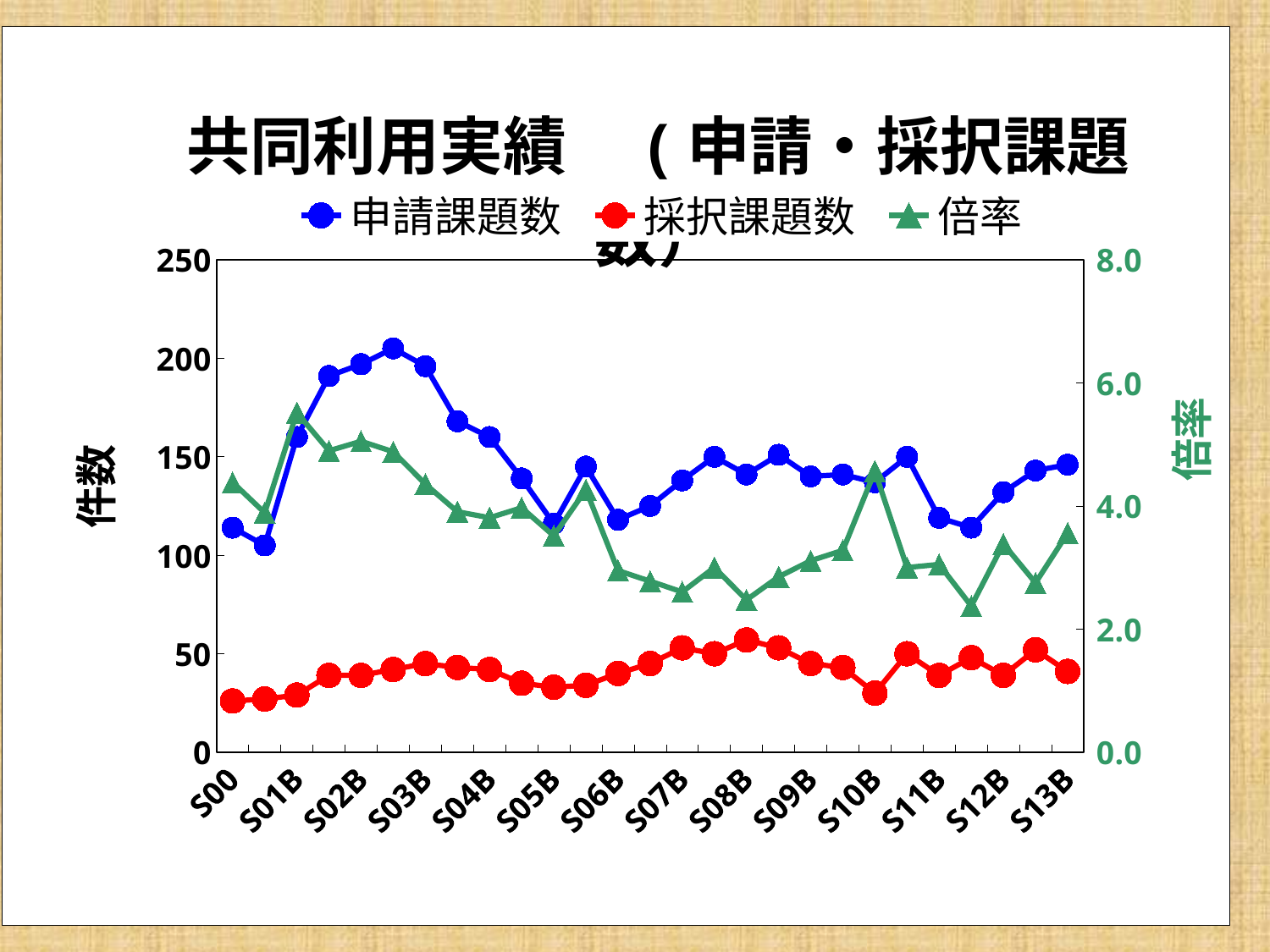
Is the value of 申請課題数 at S00 greater or less than 150? less Is the value of 申請課題数 at S03B greater or less than 150? greater Is the value of 倍率 at S08B greater or less than 4.0? less Does 申請課題数 rise or fall from S02B to S05B? fall Which series is higher at S10B, 申請課題数 or 採択課題数? 申請課題数 Which is larger, 申請課題数 at S03B or 申請課題数 at S12B? S03B How many series does the legend list? 3 How many category labels are shown on the x axis? 14 What kind of chart is shown on the slide? line chart What is the title of the right-hand vertical axis? 倍率